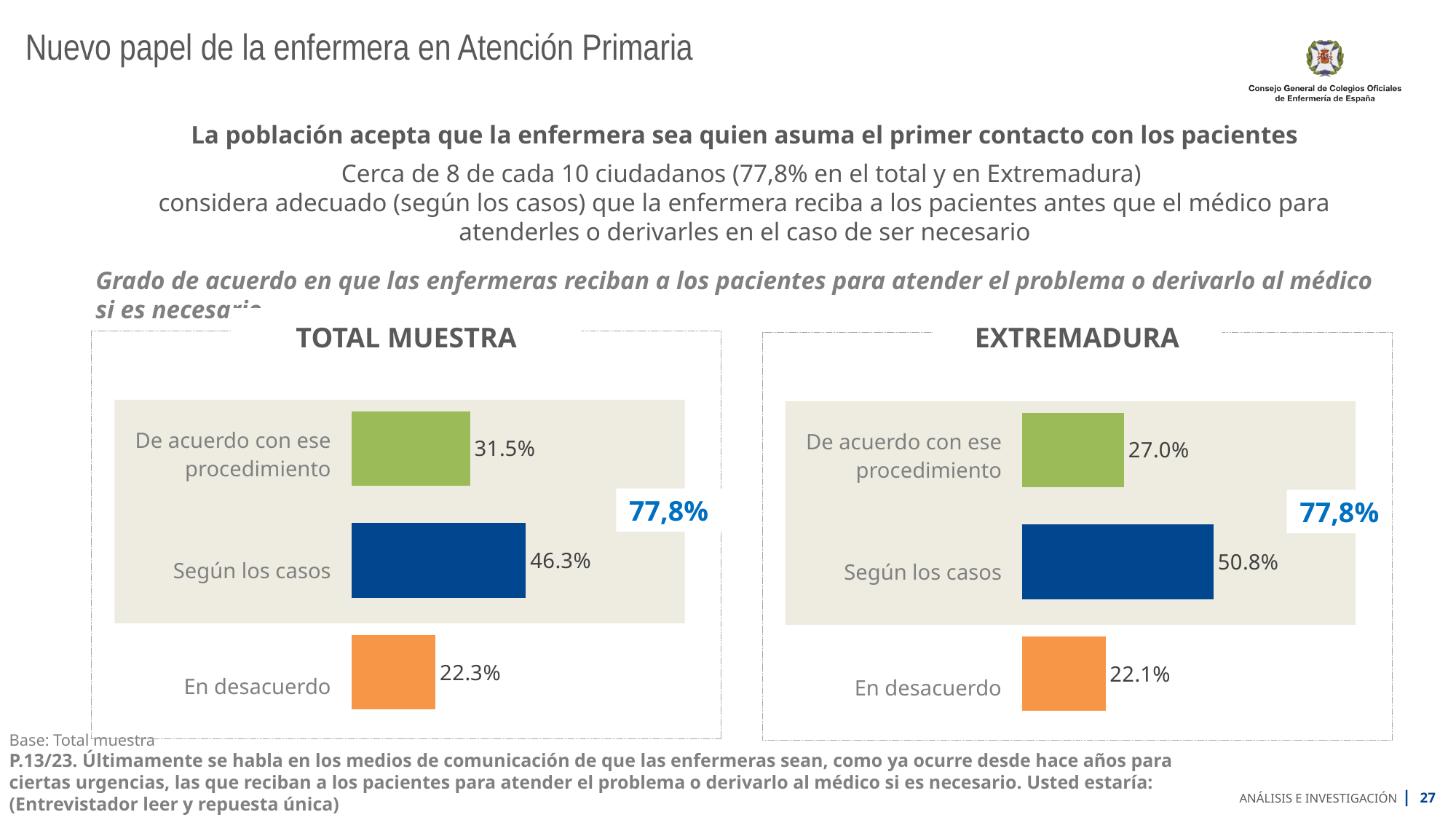
In the EXTREMADURA chart, what is the value for "En desacuerdo"? 22.1% In the EXTREMADURA chart, what is the value for "De acuerdo con ese procedimiento"? 27.0% In the TOTAL MUESTRA chart, which category has the highest value? Según los casos In the EXTREMADURA chart, what is the difference between "Según los casos" and "En desacuerdo"? 28.7% What kind of chart is the EXTREMADURA chart? Bar chart How many categories does the TOTAL MUESTRA chart show? 3 Which is larger: "Según los casos" in the TOTAL MUESTRA chart or "Según los casos" in the EXTREMADURA chart? EXTREMADURA In the TOTAL MUESTRA chart, what colour is the bar for "En desacuerdo"? Orange In the TOTAL MUESTRA chart, what is the value for "Según los casos"? 46.3% In the TOTAL MUESTRA chart, what combined value is shown for the two agreement categories ("De acuerdo con ese procedimiento" and "Según los casos")? 77,8% In the EXTREMADURA chart, which category has the lowest value? En desacuerdo In the TOTAL MUESTRA chart, what is the difference between "Según los casos" and "De acuerdo con ese procedimiento"? 14.8%